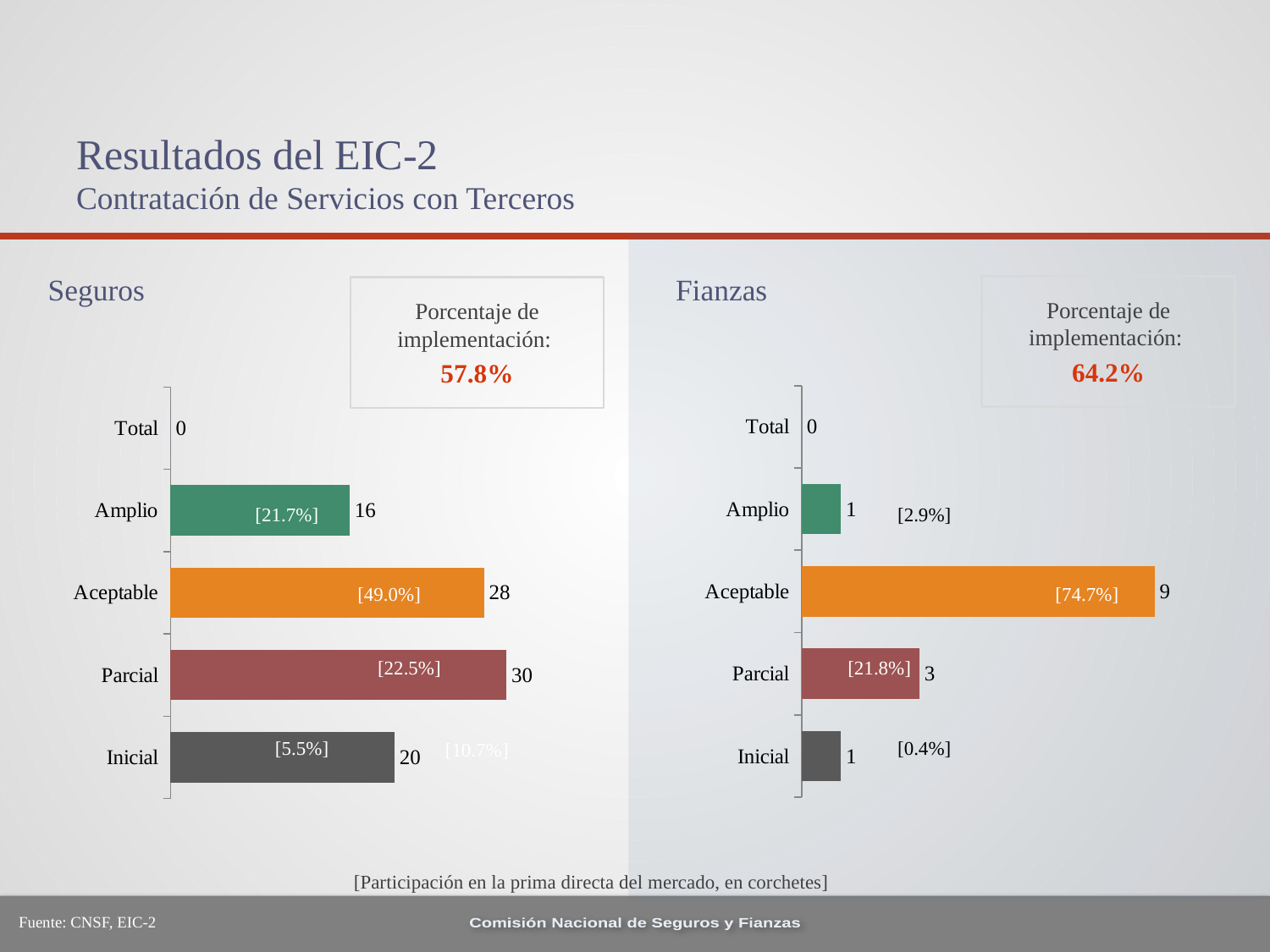
In the Fianzas chart, what is the value for Parcial? 3 In the Seguros chart, which category has the highest value? Parcial In the Fianzas chart, what is the value for Aceptable? 9 In the Seguros chart, what is the difference between the values for Parcial and Amplio? 14 What kind of chart is the Seguros chart? Bar chart In the Seguros chart, which is larger, the value for Aceptable or the value for Inicial? Aceptable In the Seguros chart, what is the value for Aceptable? 28 What percentage of implementation is shown for Fianzas? 64.2% In the Fianzas chart, which category has the highest value? Aceptable In the Fianzas chart, what is the difference between the values for Aceptable and Parcial? 6 In the Seguros chart, what is the value for Parcial? 30 How many categories are shown in the Fianzas chart? 5